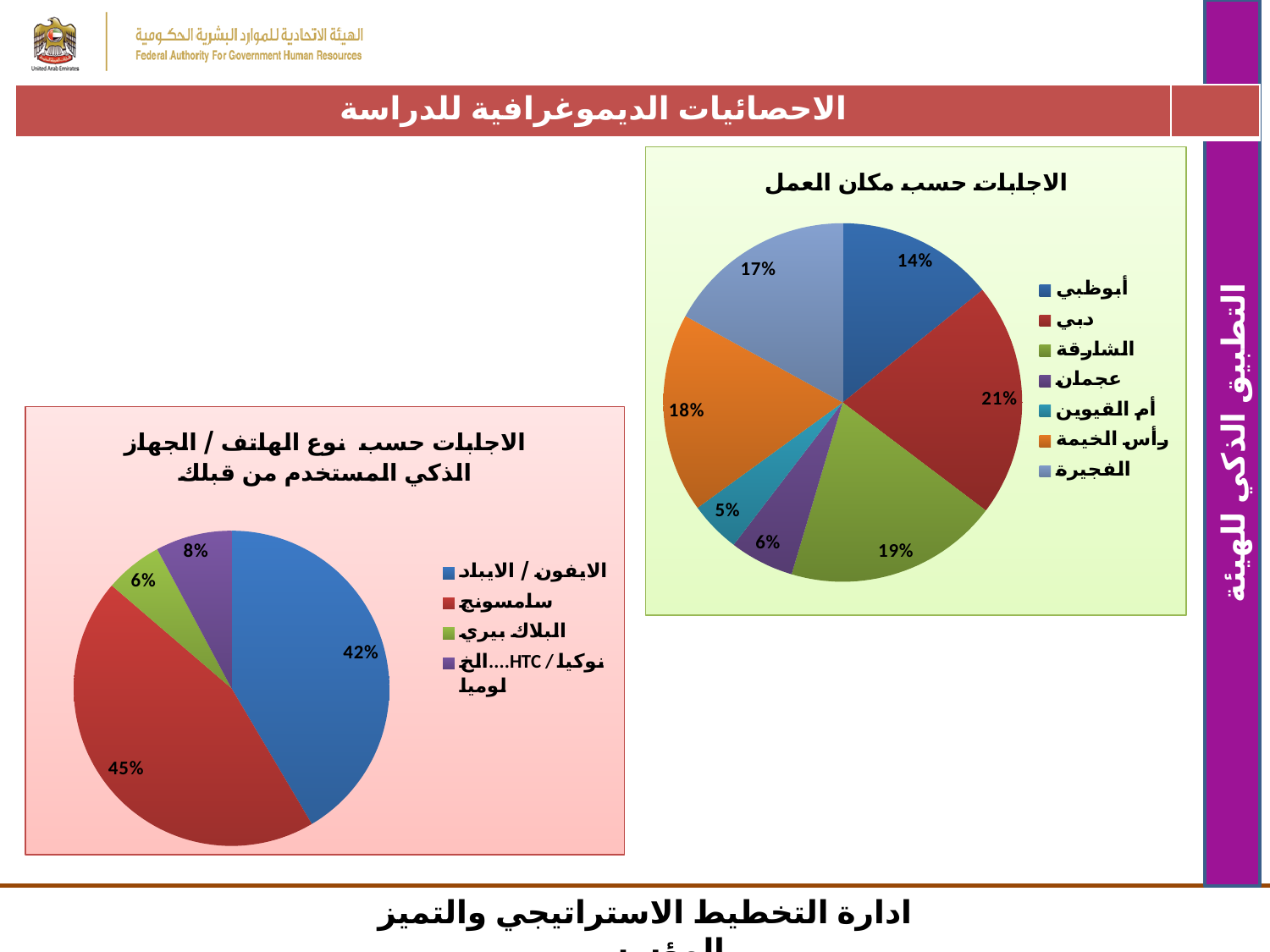
What type of chart is used for the left chart (responses by type of phone/smart device)? Pie chart In the left pie chart (responses by type of phone/smart device), what percentage is shown for البلاك بيري (BlackBerry)? 6% In the right pie chart (responses by workplace), which is larger: the share for رأس الخيمة (Ras Al Khaimah) or the share for الفجيرة (Fujairah)? رأس الخيمة (Ras Al Khaimah) In the left pie chart (responses by type of phone/smart device), what is the difference in percentage points between سامسونج (Samsung) and الايفون / الايباد (iPhone/iPad)? 3 percentage points In the right pie chart (responses by workplace), what percentage is shown for أم القيوين (Umm Al Quwain)? 5% In the right pie chart (responses by workplace), which emirate has the smallest share? أم القيوين (Umm Al Quwain) In the left pie chart (responses by type of phone/smart device), which device type has the largest share? سامسونج (Samsung) In the left pie chart (responses by type of phone/smart device), what percentage is shown for سامسونج (Samsung)? 45% In the pie chart titled "الاجابات حسب مكان العمل" (right chart), what percentage is shown for دبي (Dubai)? 21% How many categories does the legend of the right pie chart (responses by workplace) list? 7 In the right pie chart (responses by workplace), what is the difference in percentage points between الشارقة (Sharjah) and عجمان (Ajman)? 13 percentage points In the right pie chart (responses by workplace), which emirate has the largest share? دبي (Dubai)